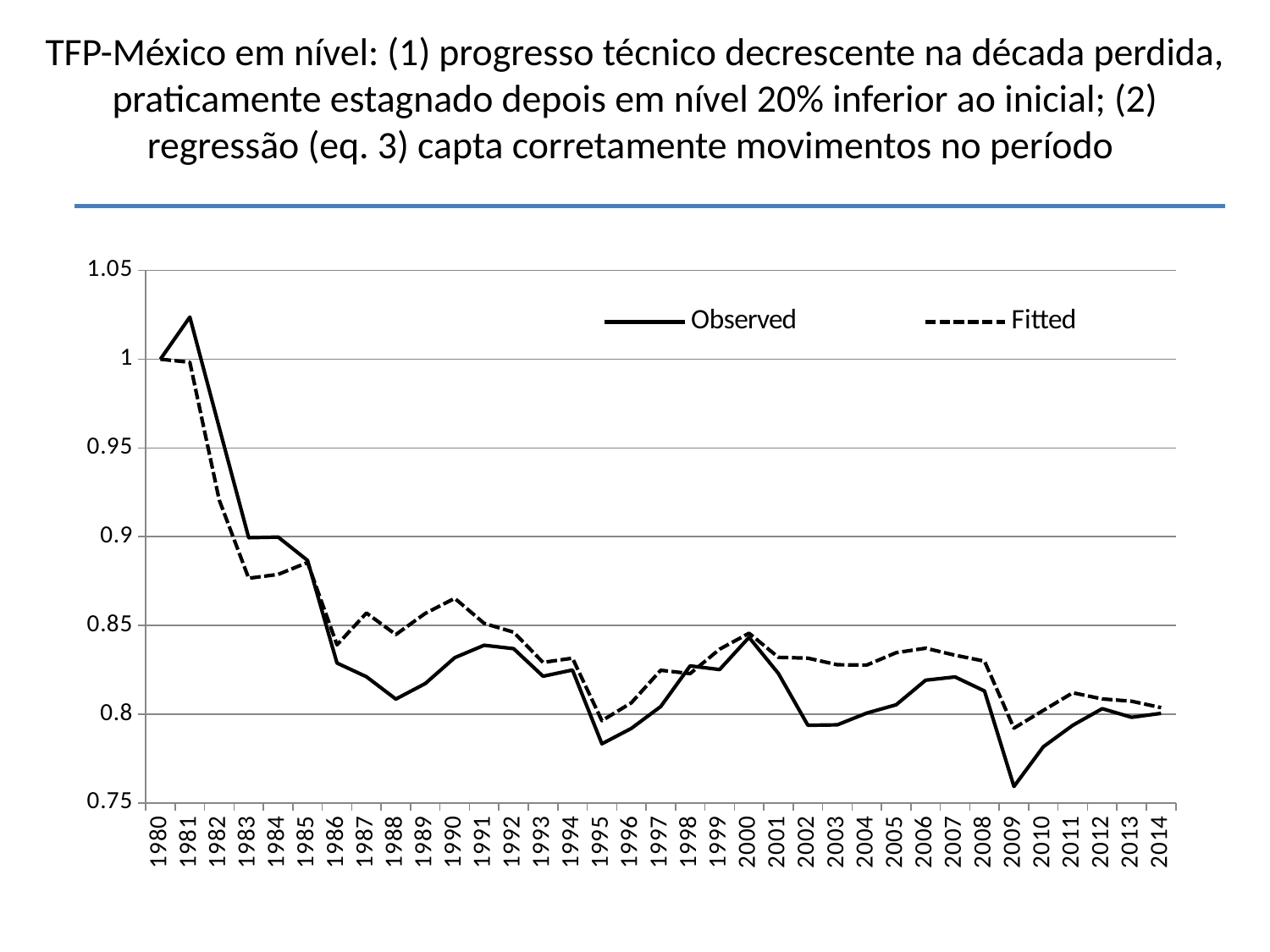
How many series does the legend list? 2 What is the Observed value in 1980? 1 Is the Observed value for 1995 greater or less than 0.8? less What are the two series named in the legend? Observed and Fitted Is the Fitted value for 1983 greater or less than 0.9? less How many years are plotted along the x axis? 35 Overall, do the Observed values rise or fall from 1980 to 2014? fall What kind of chart is shown on the slide? line chart In 1990, which series has the higher value, Observed or Fitted? Fitted Is the Fitted value for 1990 greater or less than 0.85? greater In which year does the Observed series reach its highest value? 1981 In which year does the Observed series reach its lowest value? 2009